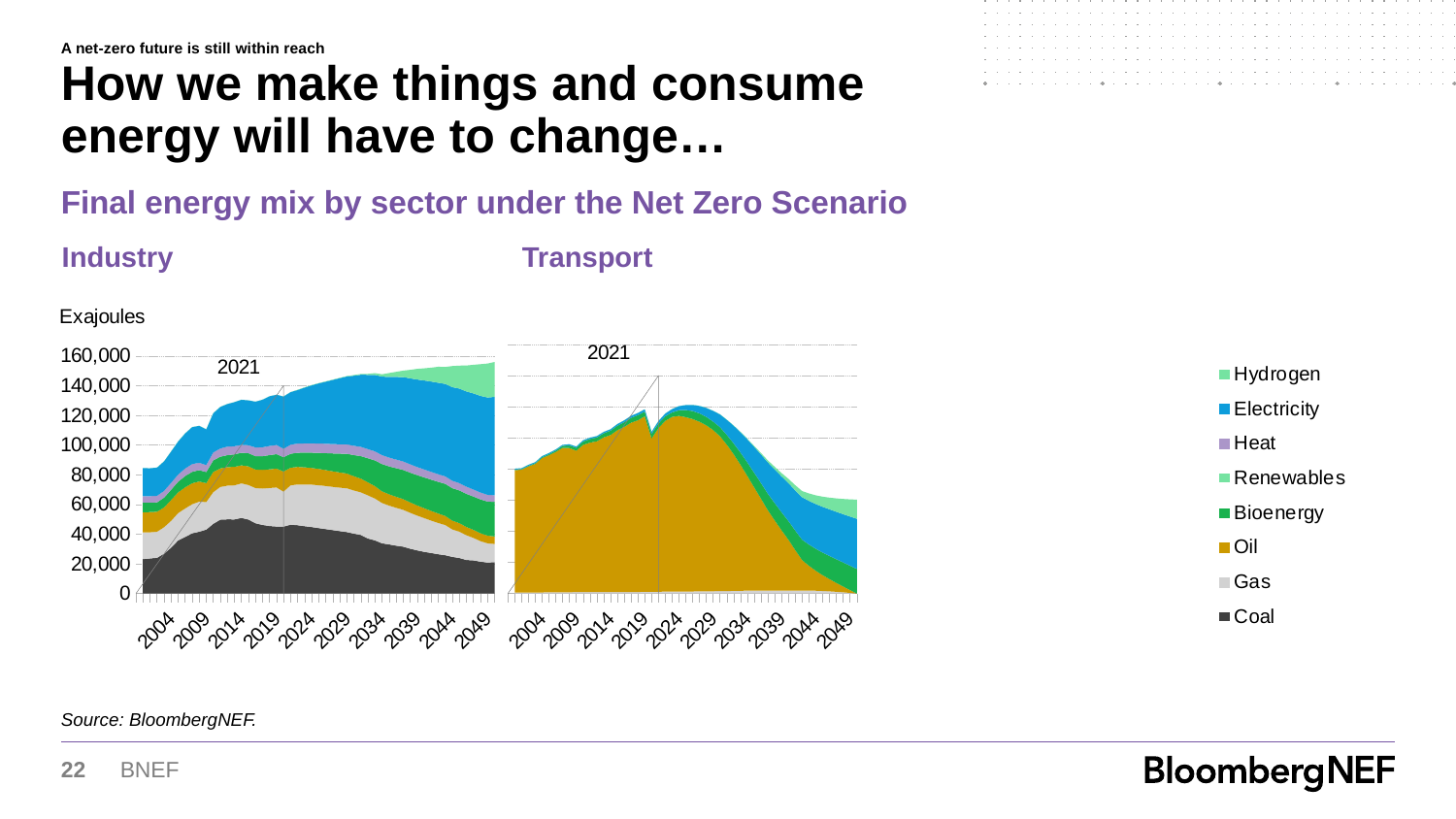
What unit is shown on the y axis of the charts? Exajoules Which year is marked by the vertical line on both the Industry and Transport charts? 2021 How many series does the legend list for the charts? 8 In the Transport chart, does the total final energy rise or fall between 2024 and 2049? fall In the Industry chart, is the total final energy in 2049 greater or less than 140,000? greater In the Transport chart, is the total final energy in 2049 greater or less than 80,000? less In the Industry chart, does the total final energy rise or fall between 2004 and 2049? rise What kind of chart is used for the Industry and Transport panels on this slide? Stacked area chart In the Transport chart, which series makes up most of the total in 2004? Oil In 2049, which chart shows the larger total final energy, Industry or Transport? Industry In the Industry chart, is the total final energy in 2004 greater or less than 100,000? less